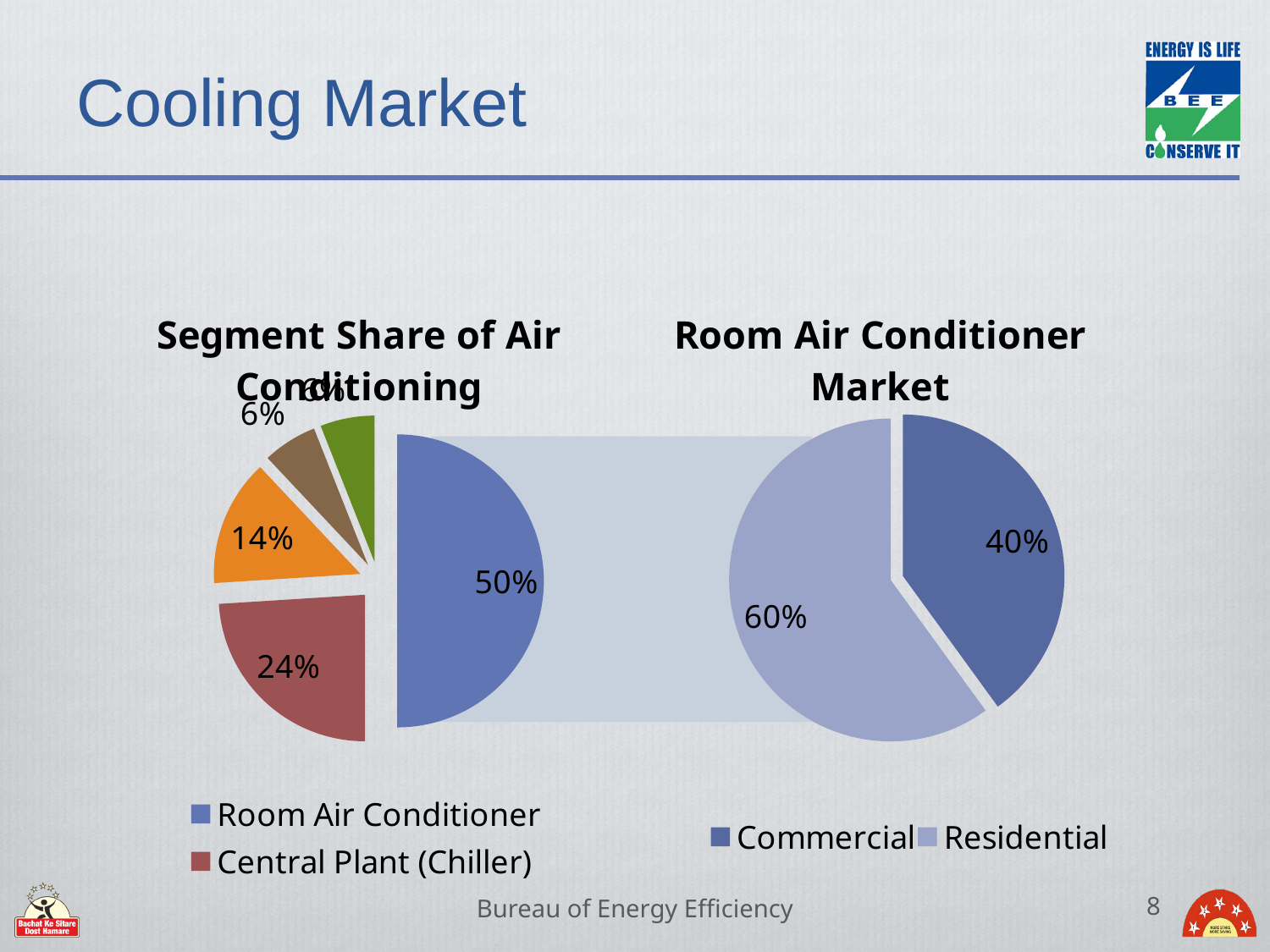
In the Room Air Conditioner Market chart, what is the difference between the Residential and Commercial shares? 20% In the Segment Share of Air Conditioning chart, what share does Central Plant (Chiller) have? 24% In the Segment Share of Air Conditioning chart, how many slices does the pie have? 5 In the Segment Share of Air Conditioning chart, what share does Room Air Conditioner have? 50% What kind of chart is the Room Air Conditioner Market chart? Pie chart In the Segment Share of Air Conditioning chart, which legend category has the largest slice? Room Air Conditioner How many entries does the legend of the Room Air Conditioner Market chart list? 2 In the Room Air Conditioner Market chart, which segment has the larger share? Residential In the Segment Share of Air Conditioning chart, what is the difference between the Room Air Conditioner share and the Central Plant (Chiller) share? 26% In the Room Air Conditioner Market chart, what share is Residential? 60% In the Segment Share of Air Conditioning chart, which is larger: Room Air Conditioner or Central Plant (Chiller)? Room Air Conditioner In the Room Air Conditioner Market chart, what share is Commercial? 40%